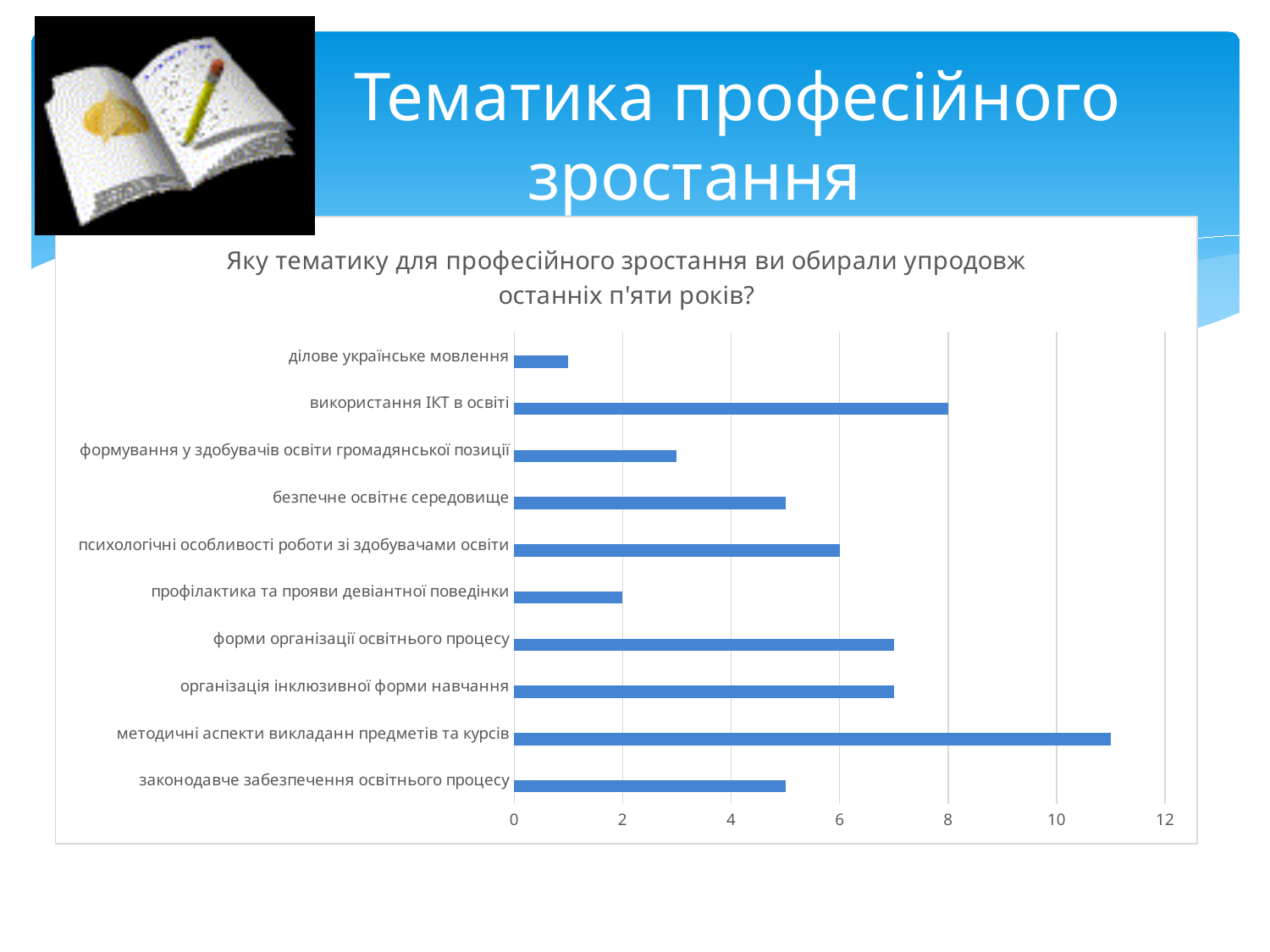
What is the difference between the values for 'використання ІКТ в освіті' and 'профілактика та прояви девіантної поведінки'? 6 What is the value for 'профілактика та прояви девіантної поведінки'? 2 What kind of chart is shown on the slide? bar chart How many categories (topics) are plotted in the chart? 10 Which topic has the highest value in the chart? методичні аспекти викладанн предметів та курсів Is the value for 'методичні аспекти викладанн предметів та курсів' greater or less than 10? greater Which topic has the lowest value in the chart? ділове українське мовлення Which is larger: the value for 'використання ІКТ в освіті' or for 'безпечне освітнє середовище'? використання ІКТ в освіті Is the value for 'ділове українське мовлення' greater or less than 2? less What is the title of the chart? Яку тематику для професійного зростання ви обирали упродовж останніх п'яти років? What is the value for 'використання ІКТ в освіті'? 8 What is the value for 'психологічні особливості роботи зі здобувачами освіти'? 6